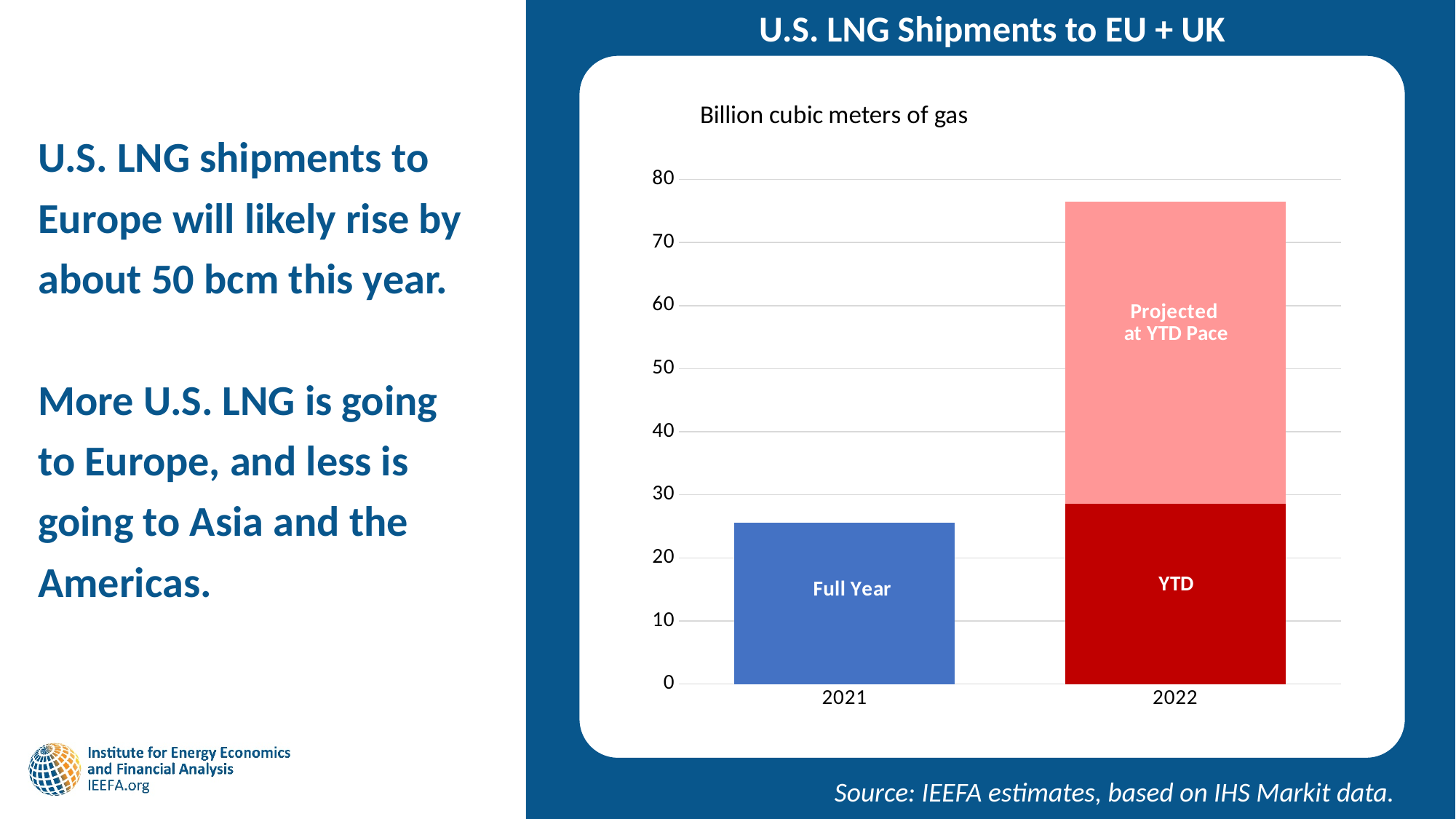
Which year has the shorter bar in the chart? 2021 What unit is the chart's y axis measured in? Billion cubic meters of gas Is the total height of the 2022 bar greater or less than 80? less Is the total height of the 2022 bar greater or less than 70? greater How many years are shown on the x axis of the chart? 2 Which is larger: the 2021 Full Year bar or the 2022 YTD segment? 2022 YTD Do the bar totals rise or fall from 2021 to 2022? rise Is the 2021 Full Year value greater or less than 20? greater Which year has the taller bar in the chart? 2022 What kind of chart is shown on the slide? bar chart